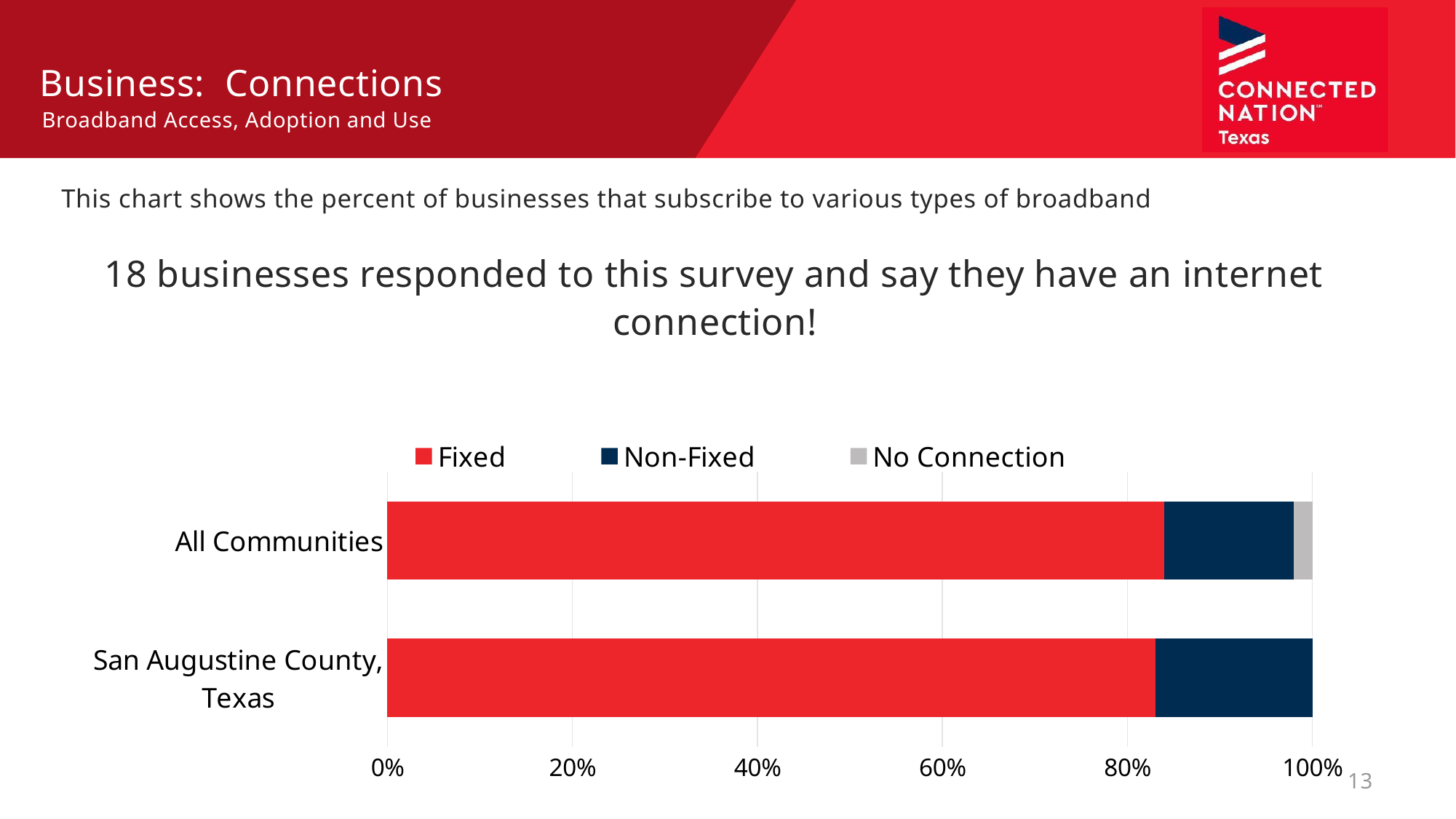
Is the Fixed value for All Communities greater or less than 100%? less Which category shows a visible No Connection segment? All Communities Which series is shown in red on the chart? Fixed Which categories are shown on the chart's vertical axis? All Communities and San Augustine County, Texas Is the Fixed value for San Augustine County, Texas greater or less than 80%? greater Which series makes up the largest share of the bar for San Augustine County, Texas? Fixed Is the Non-Fixed value for San Augustine County, Texas greater or less than 20%? less What kind of chart is shown on the slide? Stacked bar chart How many categories are plotted on the chart? 2 How many series does the chart's legend list? 3